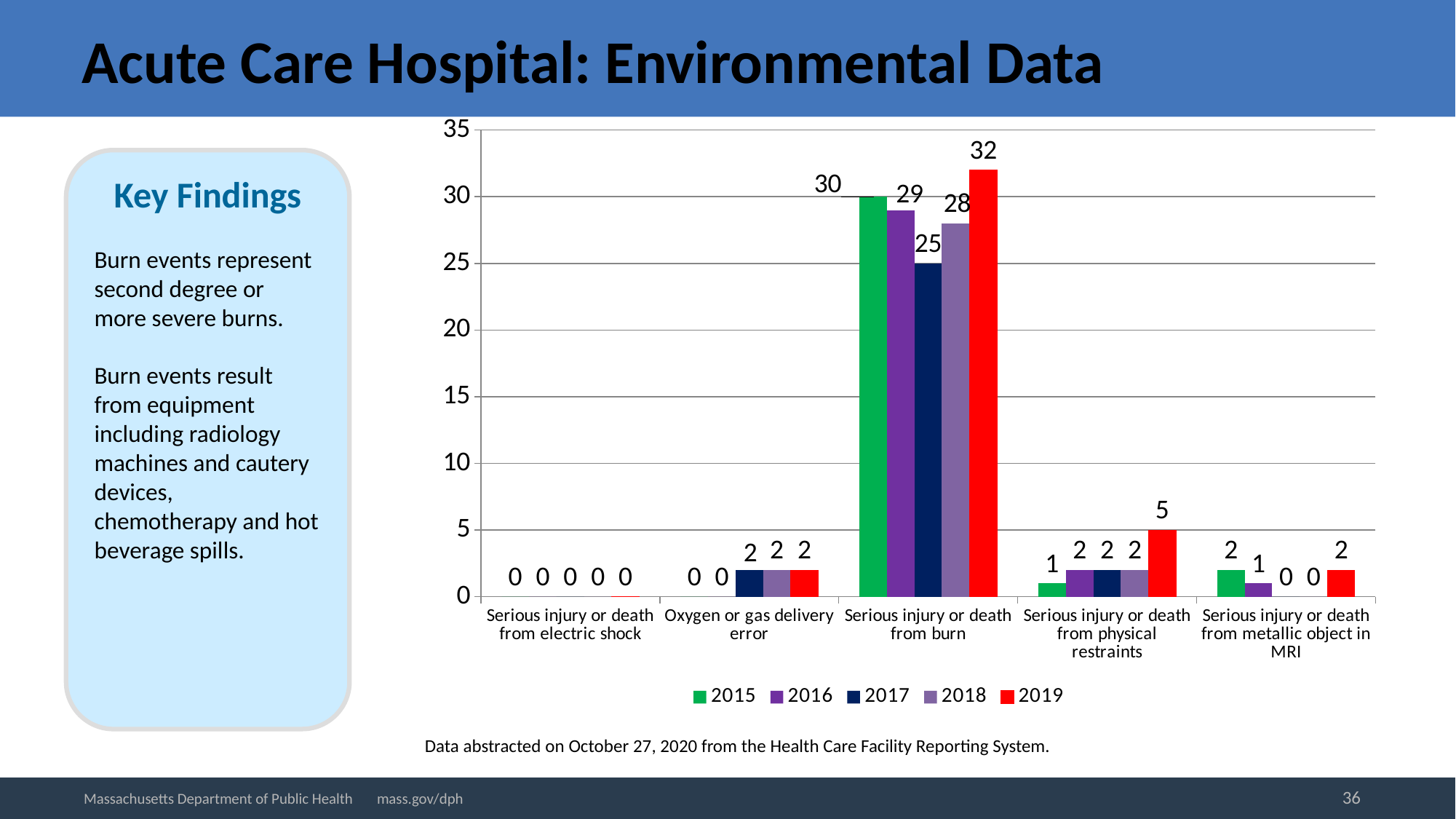
Which year has the lowest value in the 'Serious injury or death from burn' category? 2017 What is the value for 2016 in the 'Serious injury or death from metallic object in MRI' category? 1 Which year has the highest value in the 'Serious injury or death from burn' category? 2019 What is the value for 2017 in the 'Serious injury or death from burn' category? 25 Which colour represents 2019 in the legend? Red How many series does the legend list? 5 Which is larger in the 'Serious injury or death from physical restraints' category: the 2015 value or the 2019 value? 2019 What is the difference between the 2019 and 2015 values in the 'Serious injury or death from burn' category? 2 What is the value for 2019 in the 'Serious injury or death from physical restraints' category? 5 What is the value for 2019 in the 'Serious injury or death from burn' category? 32 How many categories are shown on the x axis? 5 What kind of chart is shown on the slide? Bar chart